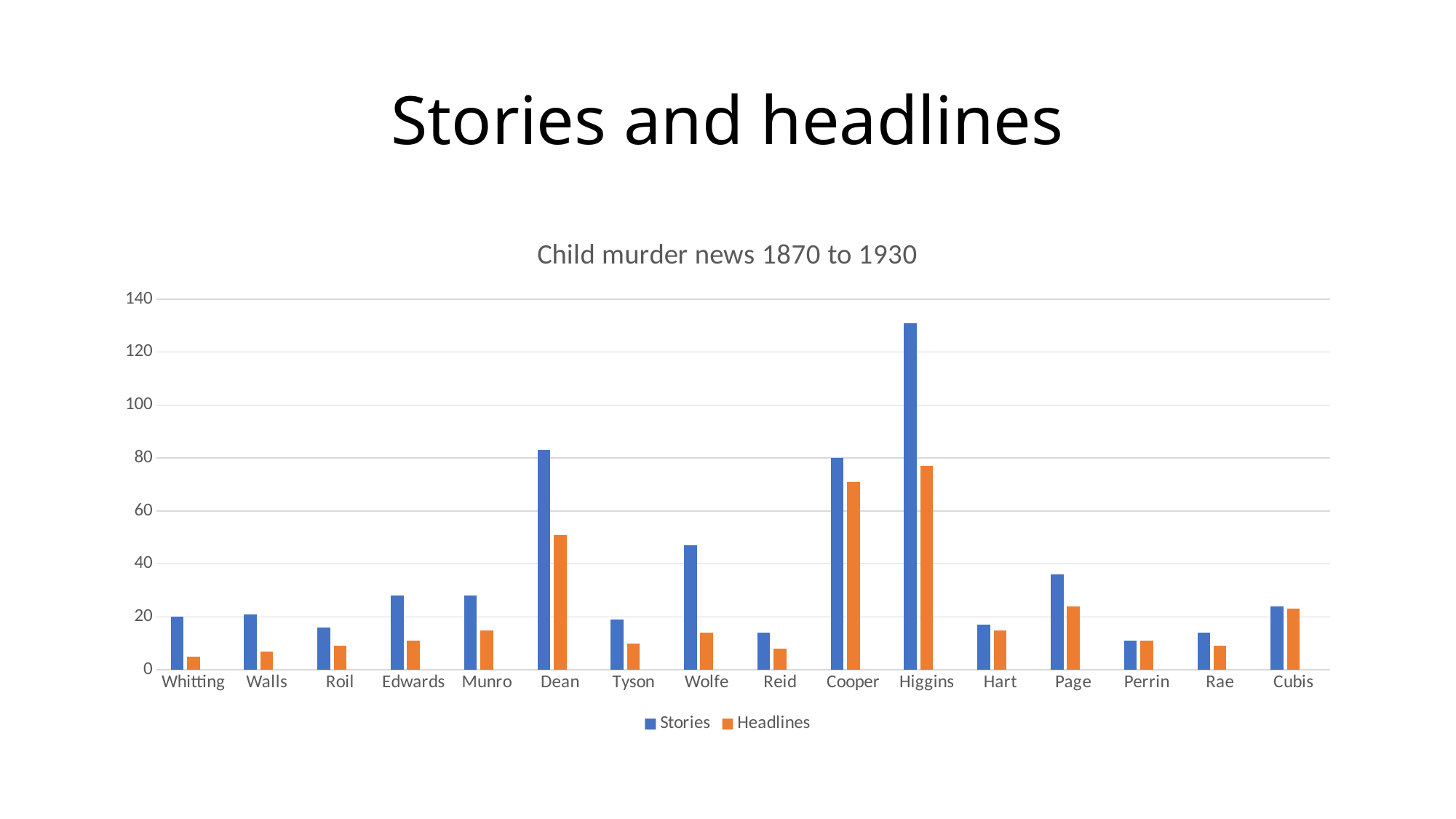
Which category has the highest value for Stories? Higgins Is the Stories value for Dean greater or less than 60? greater For Dean, which is larger: Stories or Headlines? Stories Is the Headlines value for Whitting greater or less than 20? less Which is larger: the Stories value for Higgins or the Stories value for Cooper? Higgins Is the Stories value for Higgins greater or less than 120? greater What is the title of the chart? Child murder news 1870 to 1930 How many series does the legend list? 2 How many categories are shown along the x axis? 16 What kind of chart is shown on the slide? Bar chart